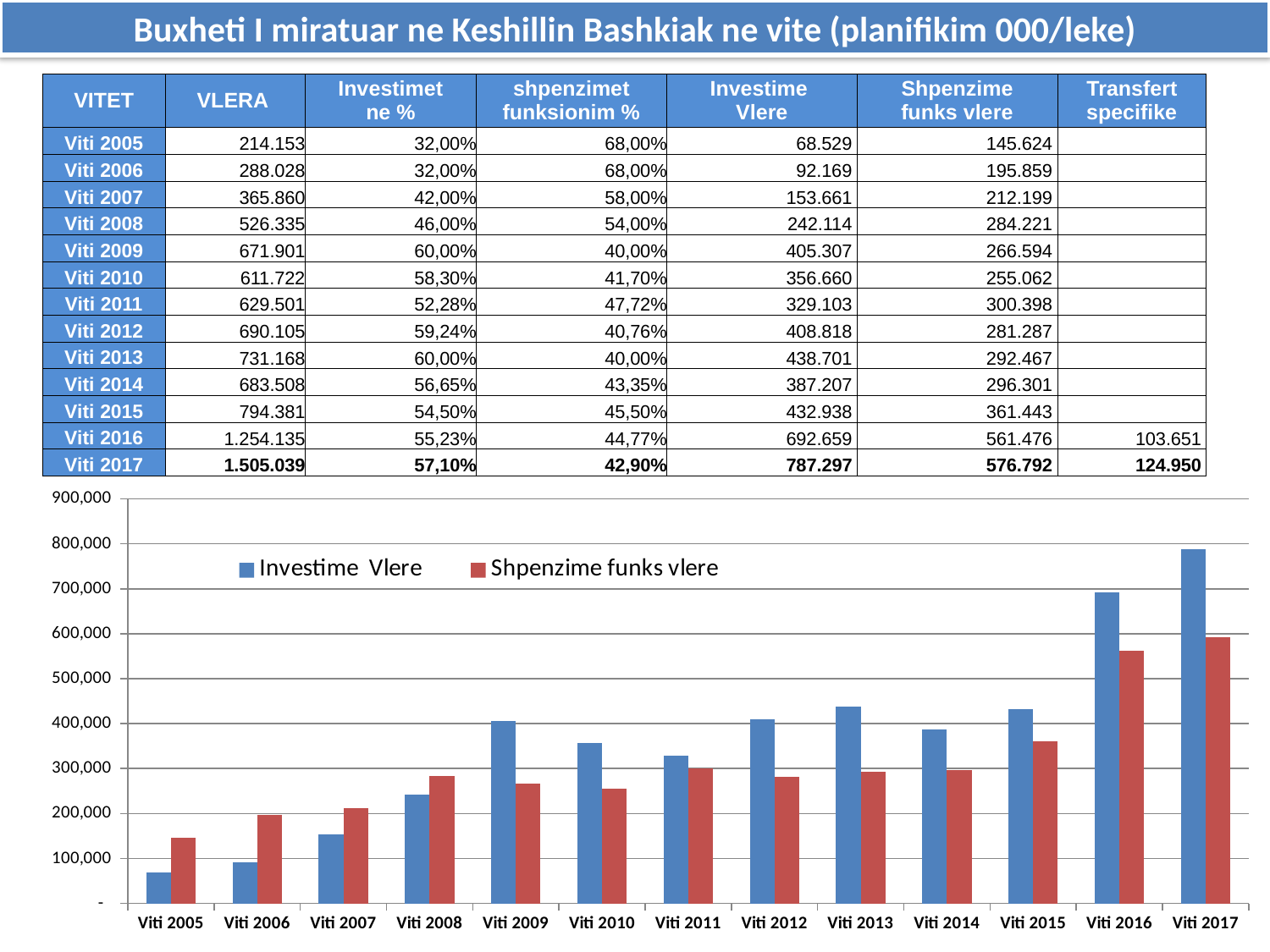
How many years (categories) are shown on the x axis of the chart? 13 According to the table, what is the Investime Vlere value for Viti 2017? 787.297 Do the Investime Vlere bars rise or fall from Viti 2005 to Viti 2009? rise How many series does the chart's legend list? 2 For Viti 2005, which is larger in the chart: Investime Vlere or Shpenzime funks vlere? Shpenzime funks vlere What kind of chart is shown on the slide? bar chart Which year has the lowest Investime Vlere bar in the chart? Viti 2005 For Viti 2017, which is larger in the chart: Investime Vlere or Shpenzime funks vlere? Investime Vlere What colour are the Investime Vlere bars in the chart? blue Which year has the highest Investime Vlere bar in the chart? Viti 2017 Is the Investime Vlere value for Viti 2016 greater or less than 600,000? greater Is the Shpenzime funks vlere value for Viti 2015 greater or less than 400,000? less